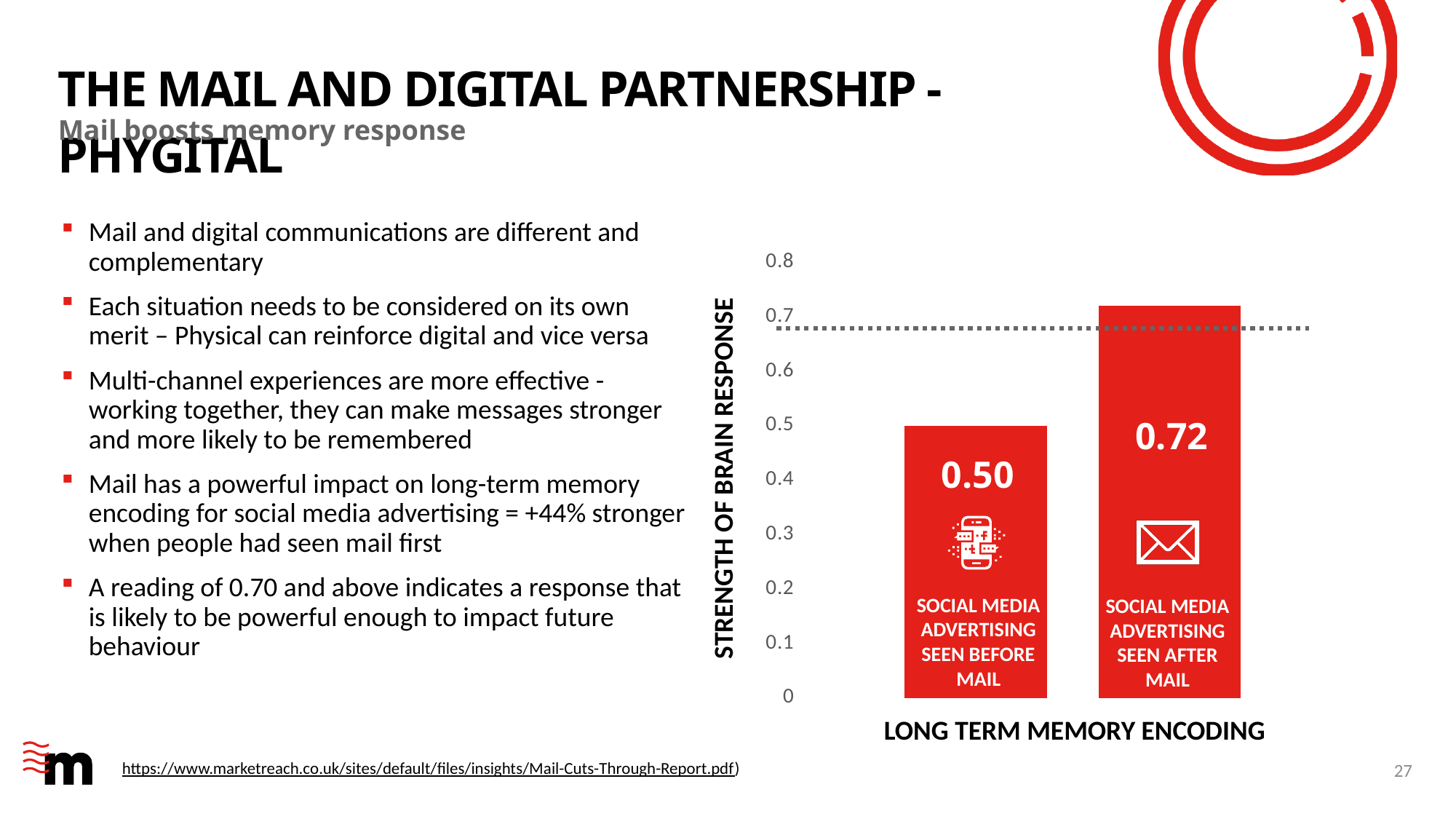
Which is larger: the value for Social Media Advertising Seen Before Mail or Seen After Mail? Social Media Advertising Seen After Mail How many bars are shown in the chart? 2 Which category has the highest value? Social Media Advertising Seen After Mail Is the value for Social Media Advertising Seen Before Mail greater or less than 0.6? less What is the value for Social Media Advertising Seen Before Mail? 0.50 What is the label of the vertical axis of the chart? Strength of Brain Response What is the label of the horizontal axis of the chart? Long Term Memory Encoding What kind of chart is shown on the slide? bar chart Is the value for Social Media Advertising Seen After Mail greater or less than 0.7? greater What is the difference between the values for Social Media Advertising Seen After Mail and Seen Before Mail? 0.22 Which category has the lowest value? Social Media Advertising Seen Before Mail What is the value for Social Media Advertising Seen After Mail? 0.72